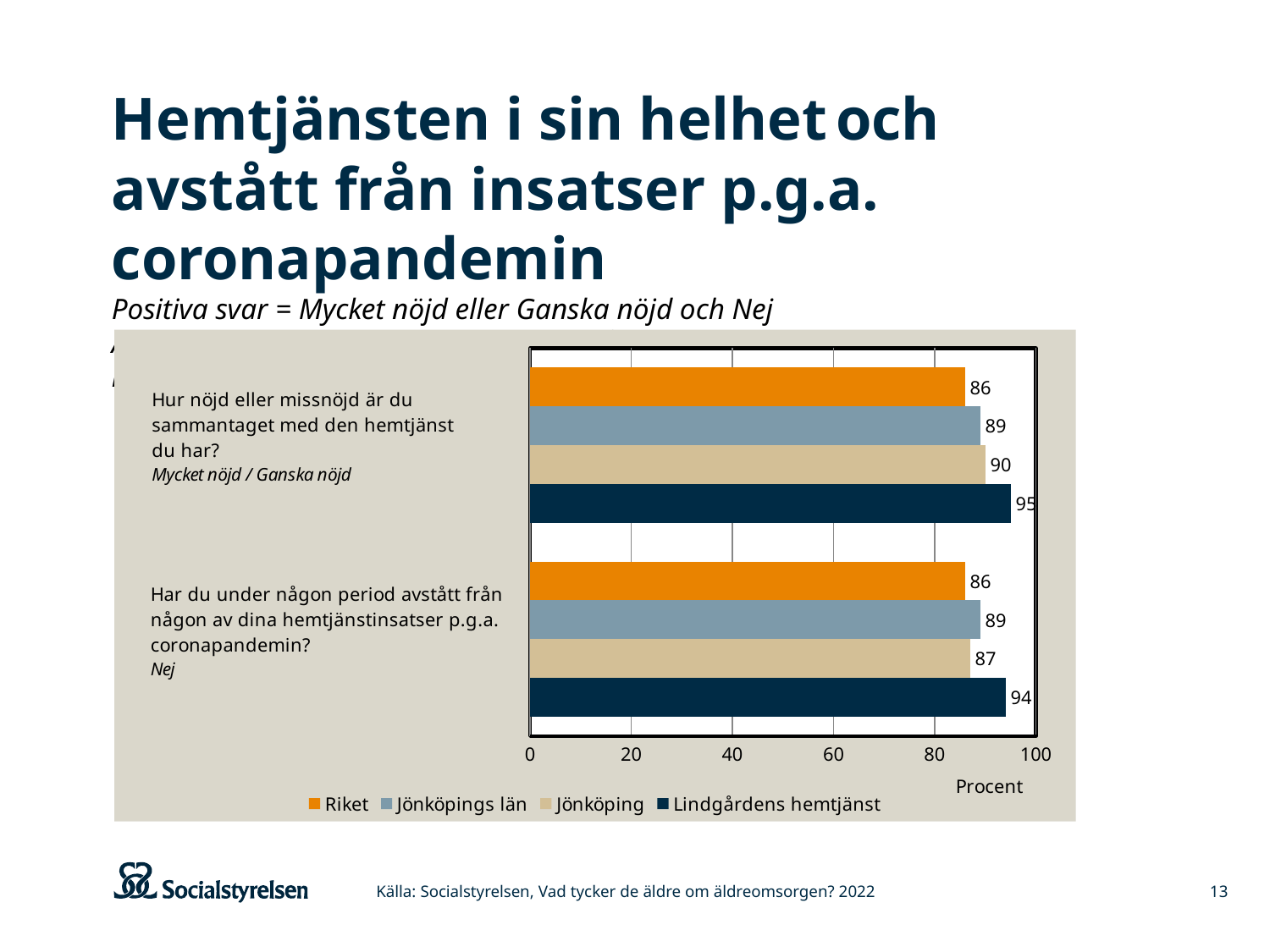
Which is larger for the question "Har du under någon period avstått från någon av dina hemtjänstinsatser p.g.a. coronapandemin?": Jönköpings län or Jönköping? Jönköpings län What is the value for Jönköpings län for the question "Har du under någon period avstått från någon av dina hemtjänstinsatser p.g.a. coronapandemin?"? 89 What is the difference between Lindgårdens hemtjänst and Riket for the question "Hur nöjd eller missnöjd är du sammantaget med den hemtjänst du har?"? 9 How many survey questions (categories) are shown on the chart? 2 What unit is shown on the x axis of the chart? Procent Which series has the lowest value for the question "Hur nöjd eller missnöjd är du sammantaget med den hemtjänst du har?"? Riket What is the value for Lindgårdens hemtjänst for the question "Hur nöjd eller missnöjd är du sammantaget med den hemtjänst du har?"? 95 Which series has the highest value for the question "Har du under någon period avstått från någon av dina hemtjänstinsatser p.g.a. coronapandemin?"? Lindgårdens hemtjänst What is the value for Riket for the question "Hur nöjd eller missnöjd är du sammantaget med den hemtjänst du har?"? 86 What is the value for Jönköping for the question "Har du under någon period avstått från någon av dina hemtjänstinsatser p.g.a. coronapandemin?"? 87 How many series does the legend list? 4 What kind of chart is shown on the slide? bar chart